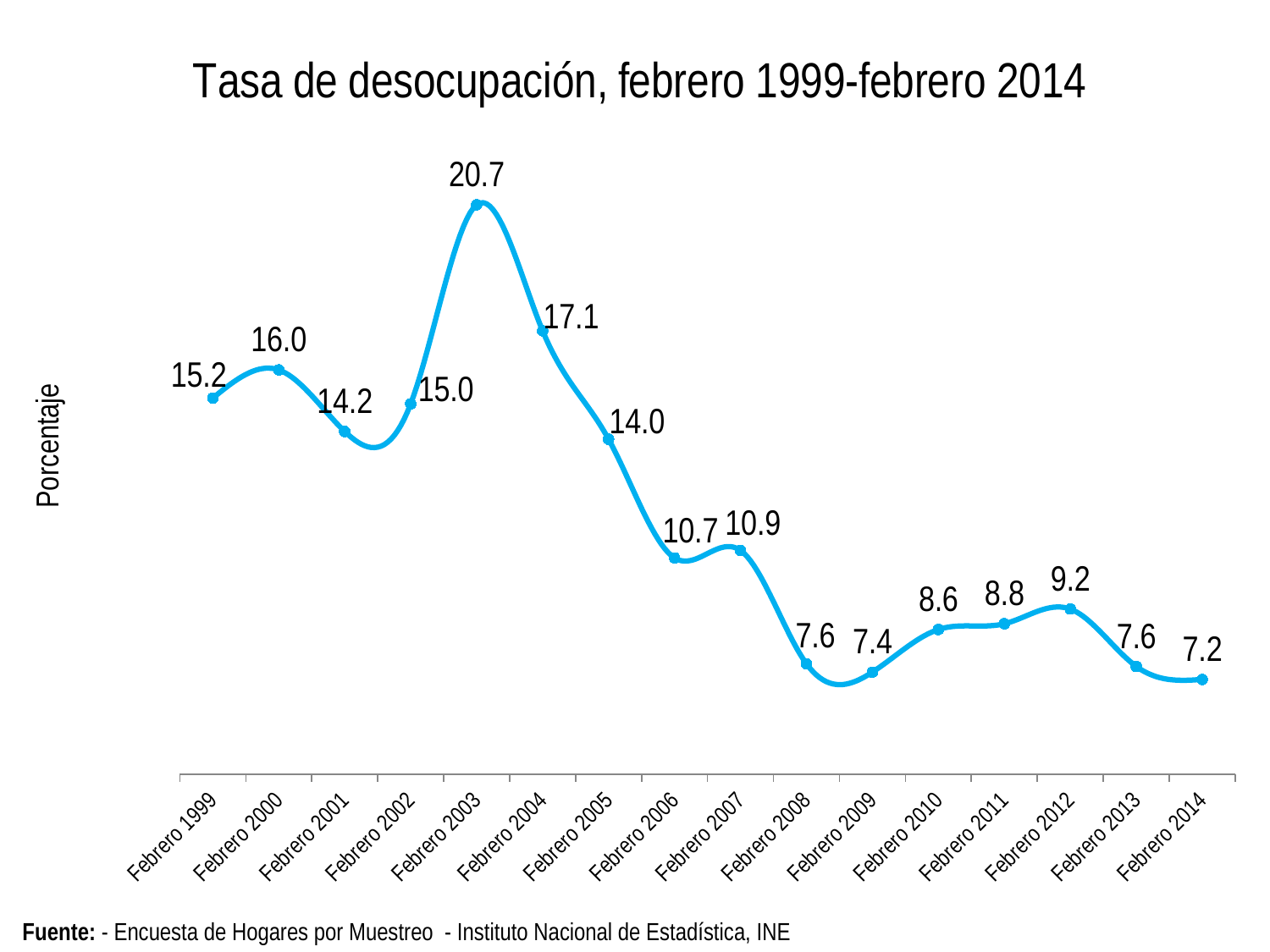
How many data points are plotted on the chart? 16 What is the unemployment rate shown for Febrero 2003? 20.7 What is the title of the chart? Tasa de desocupación, febrero 1999-febrero 2014 Does the unemployment rate generally rise or fall from Febrero 2003 to Febrero 2014? Fall Which period has the highest unemployment rate on the chart? Febrero 2003 Which is larger, the value for Febrero 2006 or the value for Febrero 2007? Febrero 2007 What kind of chart is shown on the slide? Line chart Which period has the lowest unemployment rate on the chart? Febrero 2014 What is the difference between the values for Febrero 2003 and Febrero 2004? 3.6 What is the difference between the values for Febrero 1999 and Febrero 2014? 8.0 What is the value plotted for Febrero 2014? 7.2 What is the value plotted for Febrero 1999? 15.2